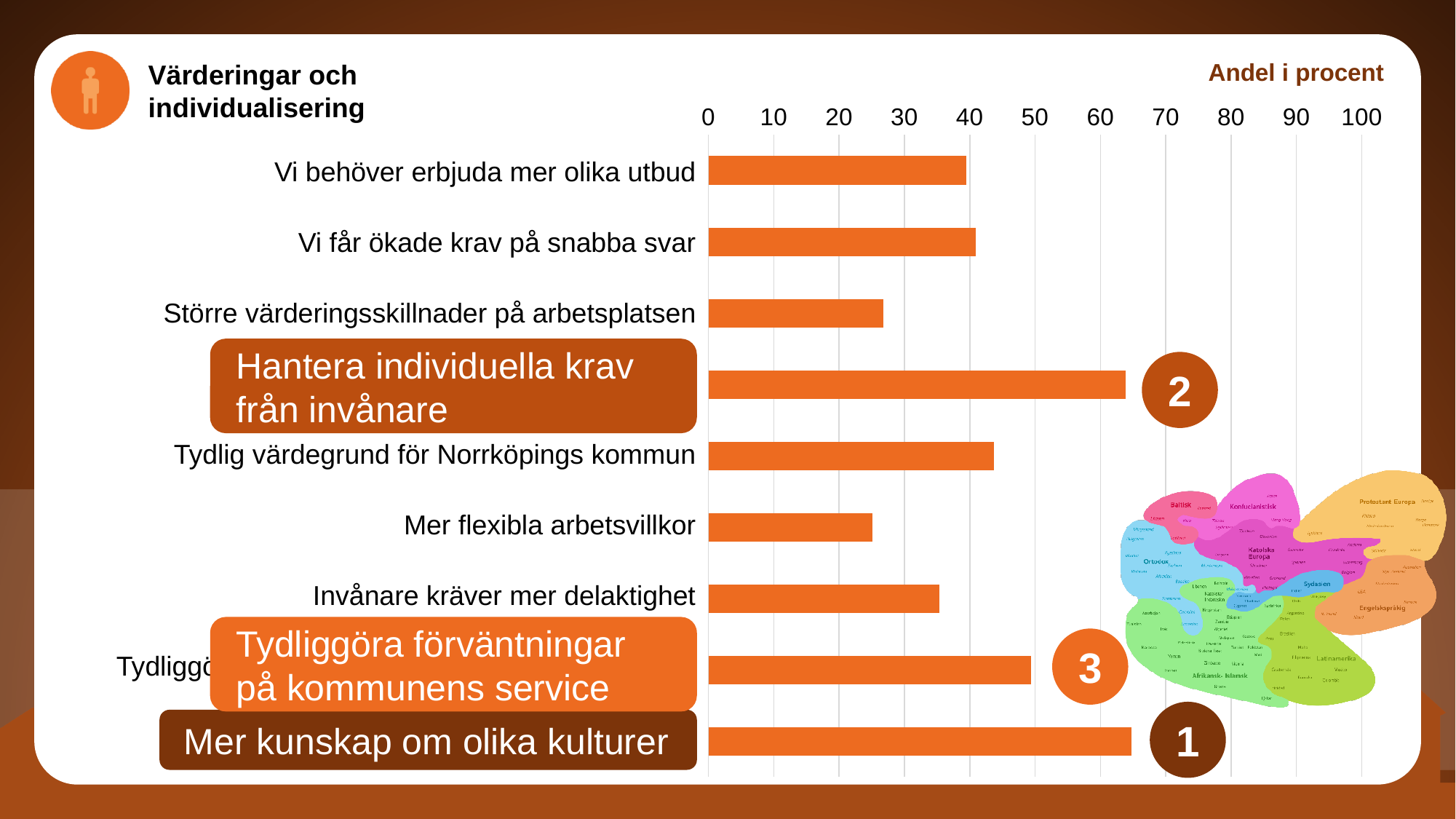
Is the value for "Större värderingsskillnader på arbetsplatsen" greater or less than 30? less How many categories (bars) does the chart show? 9 What kind of chart is shown on the slide? bar chart Is the value for "Hantera individuella krav från invånare" greater or less than 60? greater Is the value for "Tydliggöra förväntningar på kommunens service" greater or less than 40? greater What unit label is shown above the chart's value axis? Andel i procent Which has the larger value: "Hantera individuella krav från invånare" or "Mer flexibla arbetsvillkor"? Hantera individuella krav från invånare What is the title of the chart shown on the slide? Värderingar och individualisering Which has the larger value: "Tydliggöra förväntningar på kommunens service" or "Invånare kräver mer delaktighet"? Tydliggöra förväntningar på kommunens service